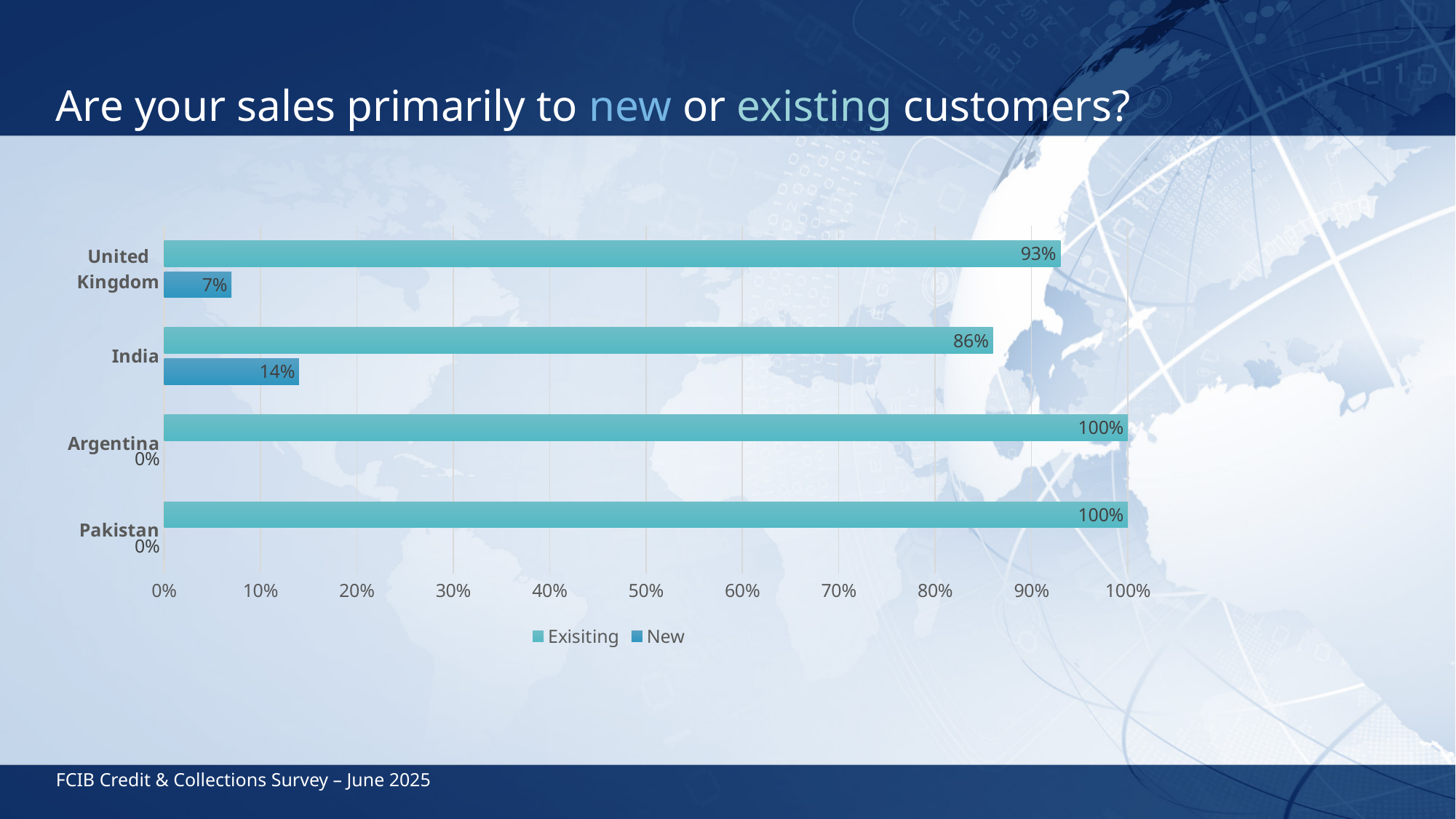
How many countries are shown on the chart? 4 How many series does the legend list? 2 What percentage of sales in India are to new customers? 14% What is the difference between the existing-customer values for the United Kingdom and India? 7% What is the value for new customers in the United Kingdom? 7% What kind of chart is shown on the slide? Bar chart What are the two series named in the legend? Exisiting and New Which country has the lowest share of sales to existing customers? India What is the value for existing customers in Argentina? 100% Which is larger: the new-customer value for India or for the United Kingdom? India What percentage of sales in the United Kingdom are to existing customers? 93% Which country has the highest share of sales to new customers? India